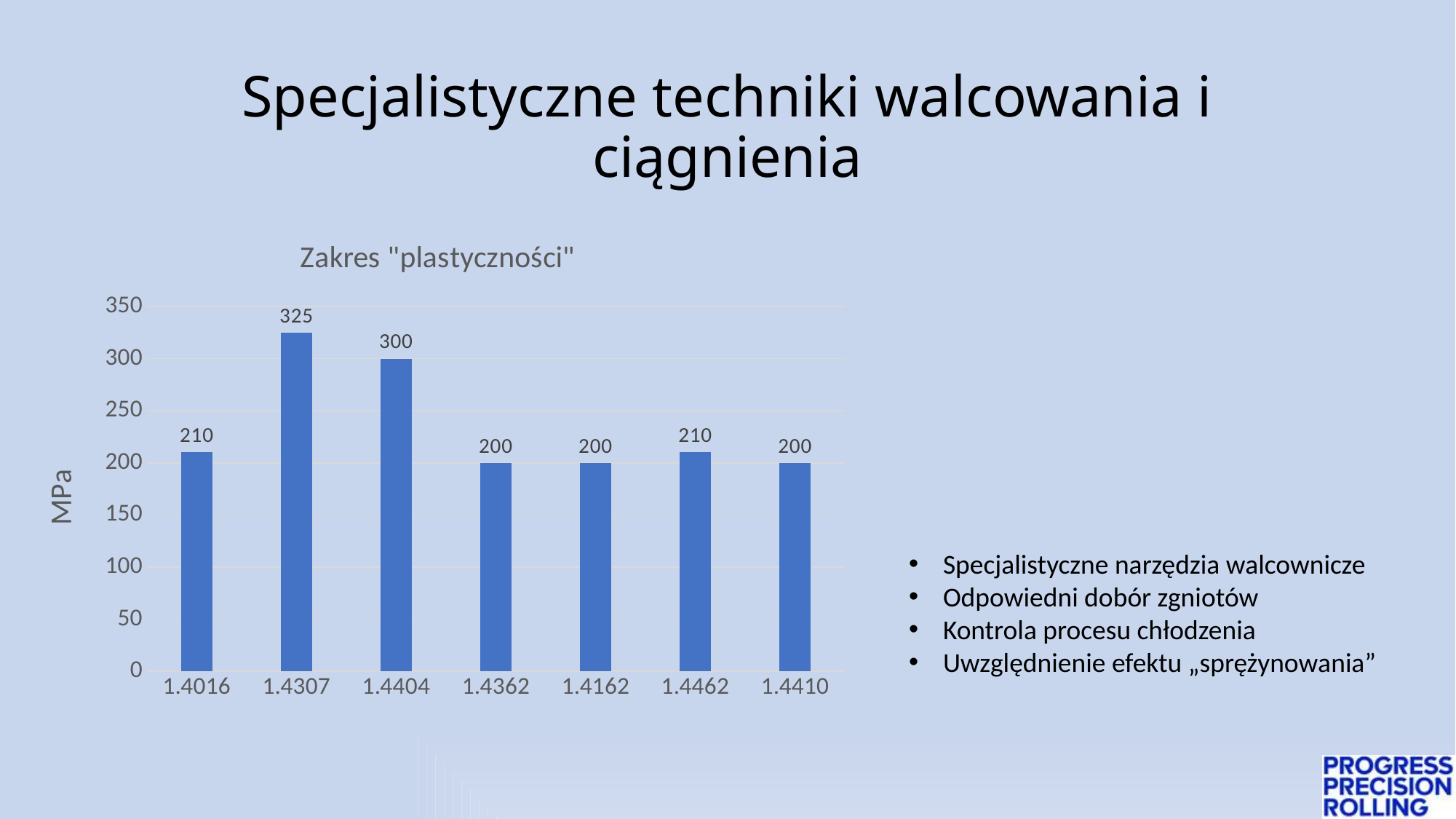
What is the label on the vertical axis of the chart? MPa What is the title of the chart? Zakres "plastyczności" How many categories are shown on the x axis of the chart? 7 What is the difference between the values for 1.4307 and 1.4404? 25 Which category has the highest value in the chart? 1.4307 What is the value for 1.4404 in the chart? 300 What is the value for 1.4307 in the chart? 325 What is the difference between the values for 1.4016 and 1.4362? 10 What is the value for 1.4016 in the chart? 210 Is the value for 1.4307 greater or less than 300? greater What kind of chart is shown on the slide? bar chart Which is larger, the value for 1.4404 or the value for 1.4462? 1.4404